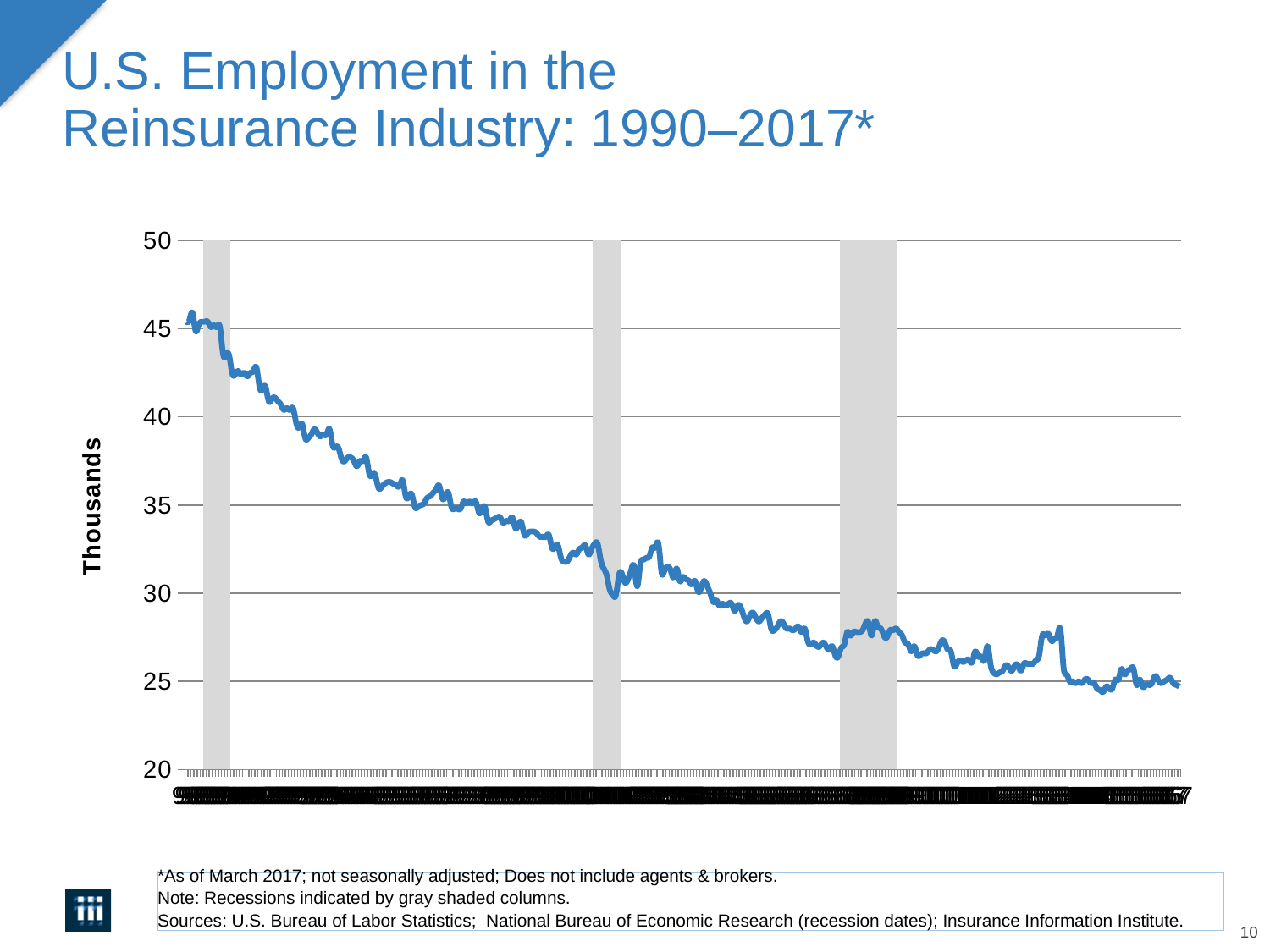
Is the value at the start of the series (1990) greater or less than 40? greater How many gray shaded recession columns are shown on the chart? 3 Is the value at the end of the series (2017) greater or less than 30? less Do the values generally rise or fall from 1990 to 2017 along the x axis? fall Is the lowest value on the chart greater or less than 30? less What is the label on the vertical axis? Thousands Is the value at the start of the series (1990) greater or less than the value at the end of the series (2017)? greater What kind of chart is shown on the slide? line chart